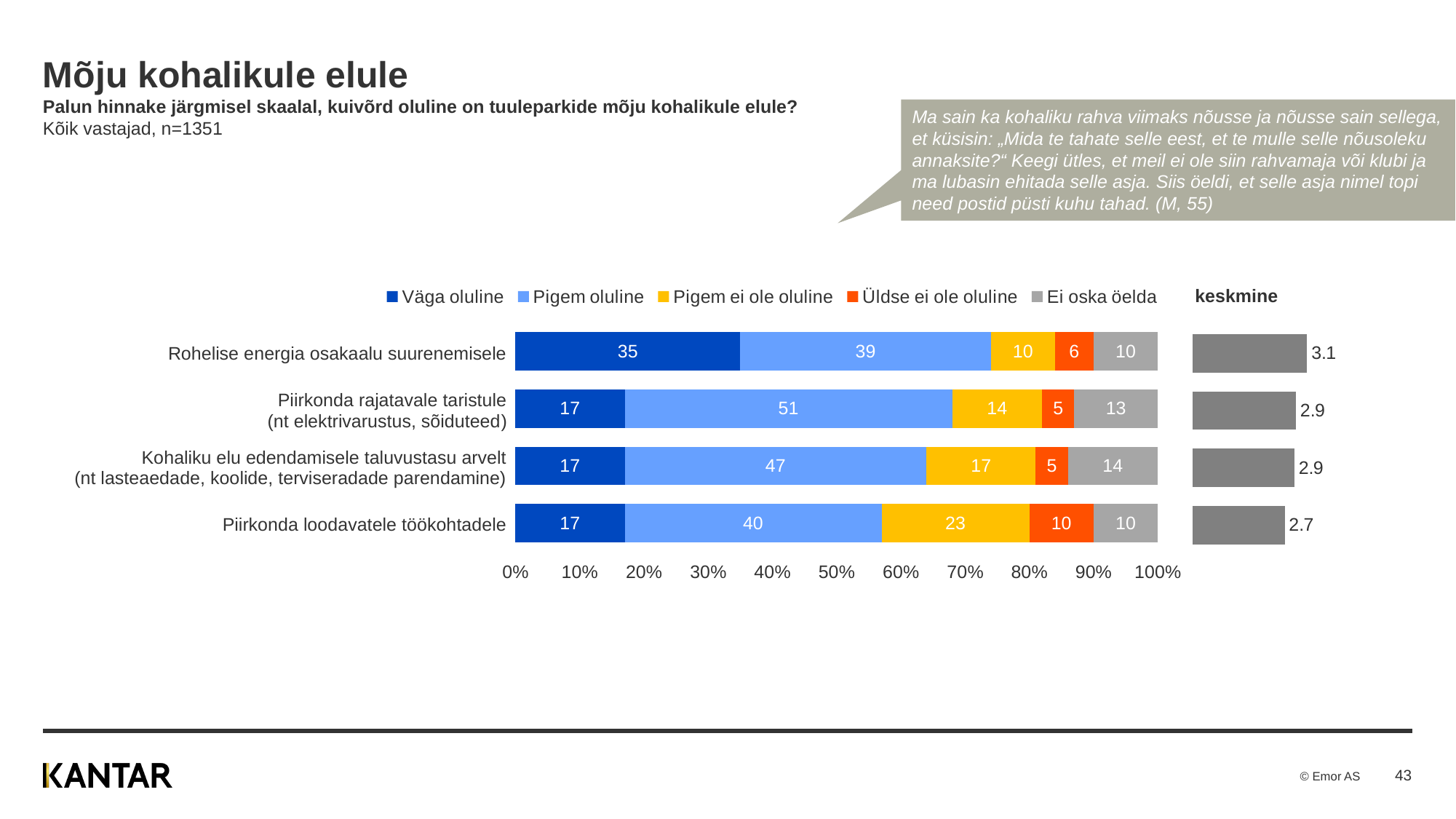
What is the total of the stacked bar for 'Kohaliku elu edendamisele taluvustasu arvelt'? 100 What is the 'keskmine' value for 'Rohelise energia osakaalu suurenemisele'? 3.1 Which category has the highest 'Väga oluline' value? Rohelise energia osakaalu suurenemisele What kind of chart is shown on the slide? stacked bar chart What is the value of 'Pigem ei ole oluline' for 'Piirkonda loodavatele töökohtadele'? 23 Which category has the lowest 'keskmine' value? Piirkonda loodavatele töökohtadele Which is larger: the 'Üldse ei ole oluline' value for 'Piirkonda loodavatele töökohtadele' or for 'Rohelise energia osakaalu suurenemisele'? Piirkonda loodavatele töökohtadele How many series does the legend of the stacked bar chart list? 5 What is the value of 'Väga oluline' for 'Rohelise energia osakaalu suurenemisele'? 35 What is the difference between the 'Pigem oluline' values for 'Piirkonda rajatavale taristule' and 'Piirkonda loodavatele töökohtadele'? 11 What is the value of 'Pigem oluline' for 'Piirkonda rajatavale taristule'? 51 How many categories are shown in the stacked bar chart? 4